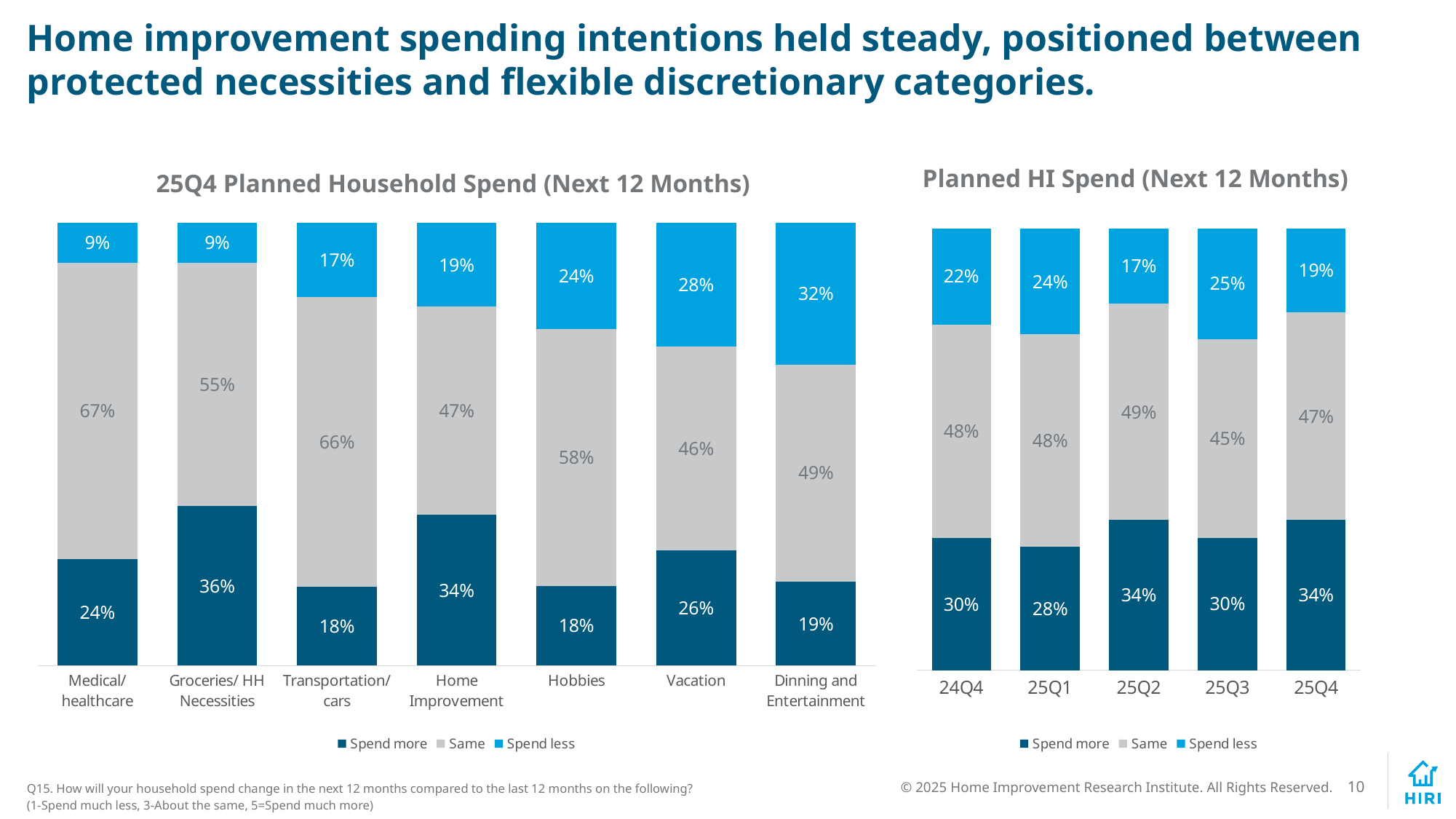
How many categories are shown in the '25Q4 Planned Household Spend (Next 12 Months)' chart? 7 In the 'Planned HI Spend (Next 12 Months)' chart, which quarter has the lowest 'Spend less' value? 25Q2 What type of chart is the 'Planned HI Spend (Next 12 Months)' chart? Stacked bar chart How many series does the legend list in the 'Planned HI Spend (Next 12 Months)' chart? 3 In the 'Planned HI Spend (Next 12 Months)' chart, what is the difference between the 'Spend more' values for 25Q1 and 25Q4? 6% In the '25Q4 Planned Household Spend (Next 12 Months)' chart, which category has the lowest 'Spend less' value? Medical/ healthcare and Groceries/ HH Necessities (both 9%) In the '25Q4 Planned Household Spend (Next 12 Months)' chart, what is the 'Spend more' value for Home Improvement? 34% In the '25Q4 Planned Household Spend (Next 12 Months)' chart, what is the difference between the 'Same' values for Medical/ healthcare and Vacation? 21% In the '25Q4 Planned Household Spend (Next 12 Months)' chart, which category has the highest 'Spend more' value? Groceries/ HH Necessities In the '25Q4 Planned Household Spend (Next 12 Months)' chart, which is larger: the 'Spend less' value for Hobbies or for Vacation? Vacation In the '25Q4 Planned Household Spend (Next 12 Months)' chart, what is the 'Spend less' value for Dinning and Entertainment? 32% In the 'Planned HI Spend (Next 12 Months)' chart, what is the 'Same' value for 25Q3? 45%